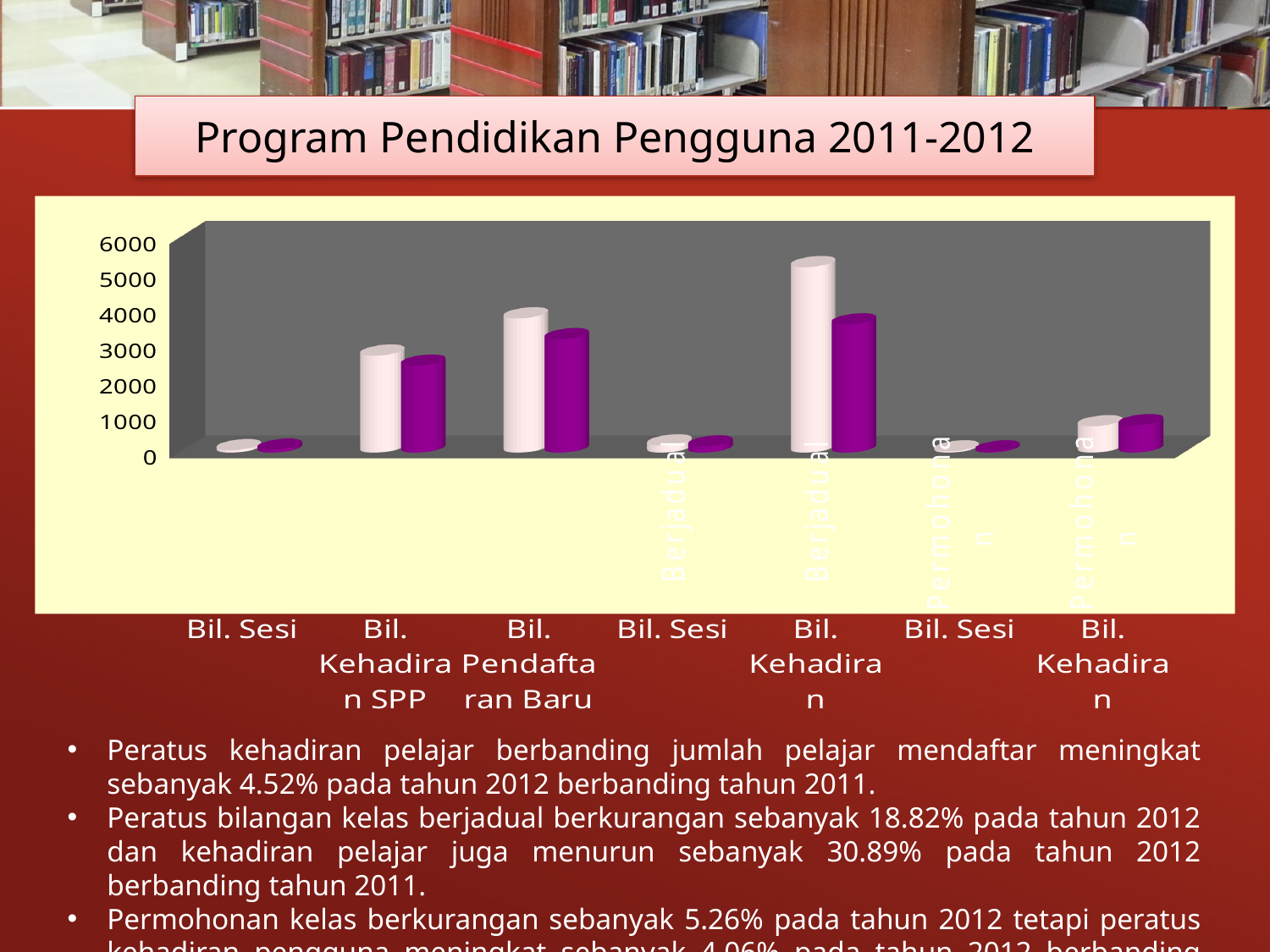
What is the title shown above the chart? Program Pendidikan Pengguna 2011-2012 What kind of chart is shown on the slide? bar chart Is the light pink bar for Bil. Pendaftaran Baru greater or less than 3000? greater For Bil. Kehadiran (Berjadual), which bar is taller, the light pink one or the purple one? light pink Is the purple bar for Bil. Kehadiran SPP greater or less than 3000? less Is the light pink bar for Bil. Sesi (the first category) greater or less than 1000? less What two colours are used for the bars in the chart? light pink and purple Which category has the tallest bar in the chart? Bil. Kehadiran (Berjadual) For Bil. Pendaftaran Baru, which bar is taller, the light pink one or the purple one? light pink How many categories are shown along the x axis of the chart? 7